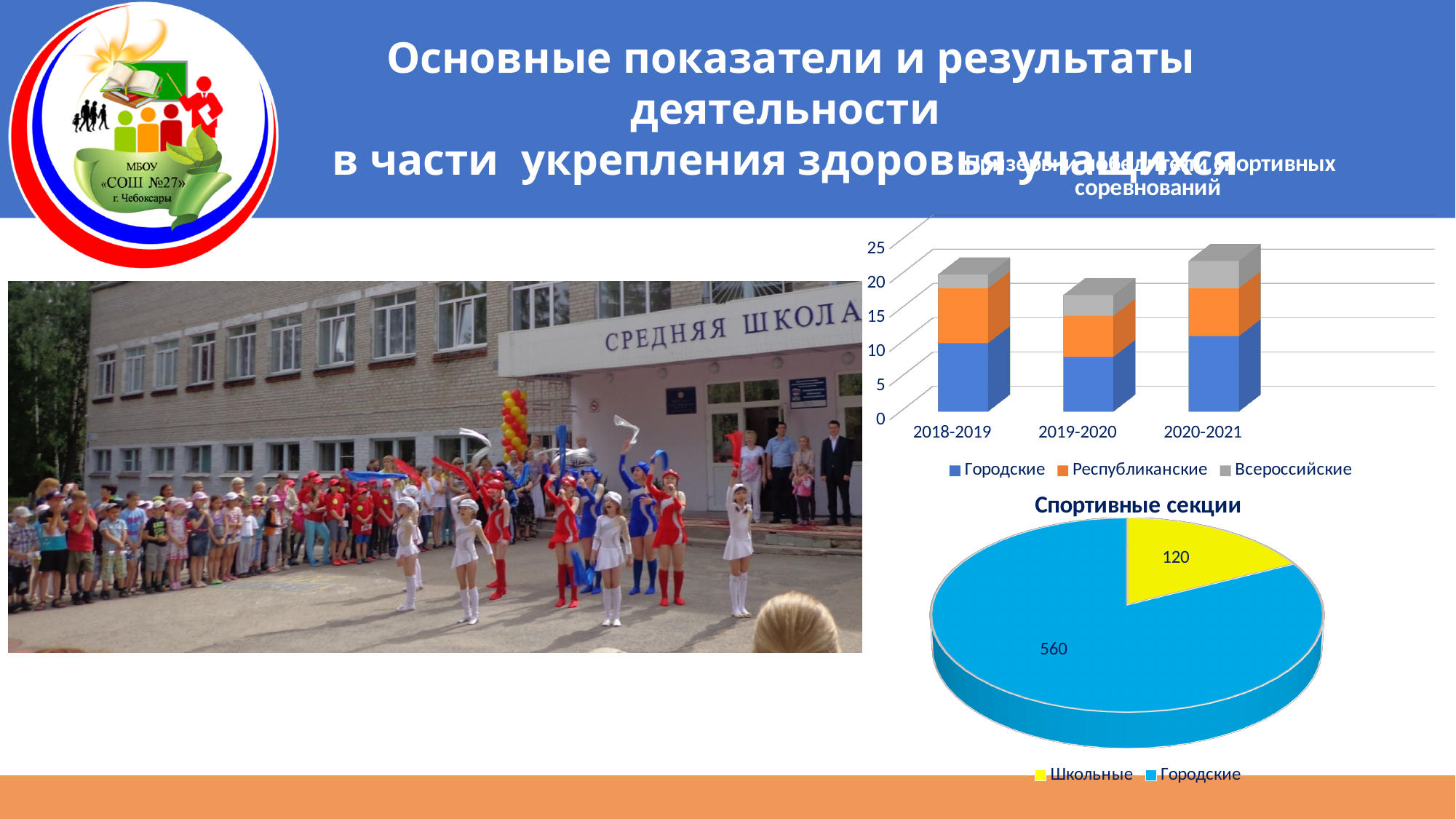
In the pie chart titled 'Спортивные секции', what is the value for Городские? 560 In the pie chart titled 'Спортивные секции', which slice is larger, Школьные or Городские? Городские What type of chart is the chart in the upper right of the slide, showing the years 2018-2019 to 2020-2021? Stacked bar chart How many slices does the pie chart titled 'Спортивные секции' have? 2 How many series does the legend of the upper-right bar chart list? 3 In the pie chart titled 'Спортивные секции', what is the total of the two slices? 680 In the pie chart titled 'Спортивные секции', what is the value for Школьные? 120 In the upper-right bar chart, which series is shown in orange? Республиканские In the upper-right bar chart, is the total height of the 2020-2021 bar greater or less than 20? greater In the pie chart titled 'Спортивные секции', what is the difference between the Городские and Школьные values? 440 In the upper-right bar chart, is the total height of the 2019-2020 bar greater or less than 20? less How many categories are shown on the x axis of the upper-right bar chart? 3